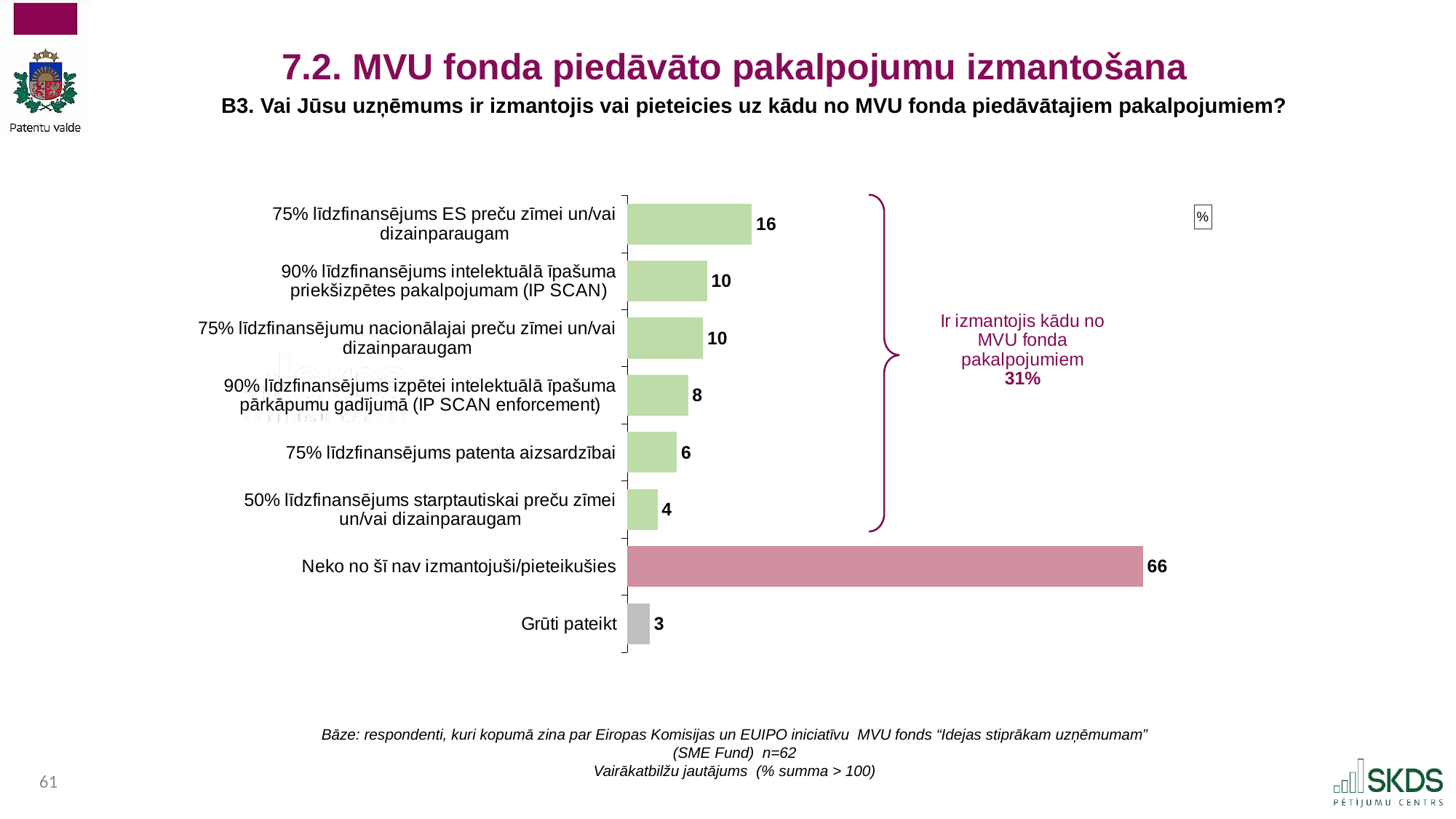
What percentage is given in the bracket annotation for "Ir izmantojis kādu no MVU fonda pakalpojumiem"? 31% What is the value for "75% līdzfinansējums patenta aizsardzībai"? 6 What is the value for "Grūti pateikt"? 3 Which category has the lowest value? Grūti pateikt What is the value for "Neko no šī nav izmantojuši/pieteikušies"? 66 Which is larger: the value for "90% līdzfinansējums izpētei intelektuālā īpašuma pārkāpumu gadījumā (IP SCAN enforcement)" or for "50% līdzfinansējums starptautiskai preču zīmei un/vai dizainparaugam"? 90% līdzfinansējums izpētei intelektuālā īpašuma pārkāpumu gadījumā (IP SCAN enforcement) How many categories are shown in the chart? 8 What is the value for "75% līdzfinansējums ES preču zīmei un/vai dizainparaugam"? 16 Which category has the highest value? Neko no šī nav izmantojuši/pieteikušies What kind of chart is shown on the slide? Bar chart What is the sample size (n) stated in the base note below the chart? n=62 What is the difference between the values for "Neko no šī nav izmantojuši/pieteikušies" and "75% līdzfinansējums ES preču zīmei un/vai dizainparaugam"? 50